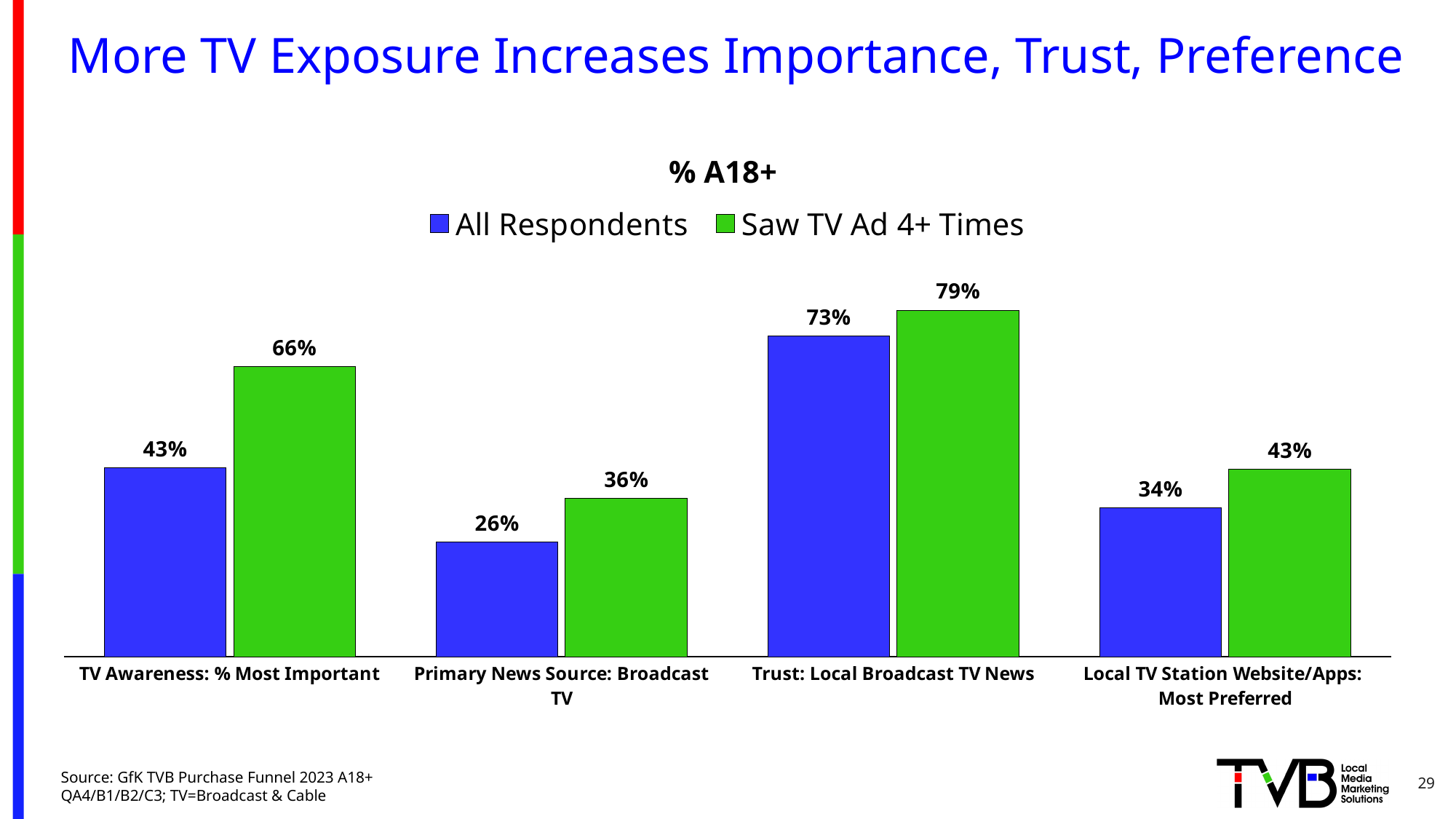
What is the value for All Respondents in the Primary News Source: Broadcast TV category? 26% Which category has the lowest value for Saw TV Ad 4+ Times? Primary News Source: Broadcast TV What kind of chart is shown on the slide? Bar chart What is the title of the chart? % A18+ Which is larger in the Local TV Station Website/Apps: Most Preferred category: All Respondents or Saw TV Ad 4+ Times? Saw TV Ad 4+ Times How many series does the legend list? 2 What is the difference between Saw TV Ad 4+ Times and All Respondents in the TV Awareness: % Most Important category? 23% What is the value for All Respondents in the TV Awareness: % Most Important category? 43% What is the value for Saw TV Ad 4+ Times in the Trust: Local Broadcast TV News category? 79% Which category has the highest value for All Respondents? Trust: Local Broadcast TV News What is the value for Saw TV Ad 4+ Times in the Local TV Station Website/Apps: Most Preferred category? 43% How many categories are shown on the x axis? 4